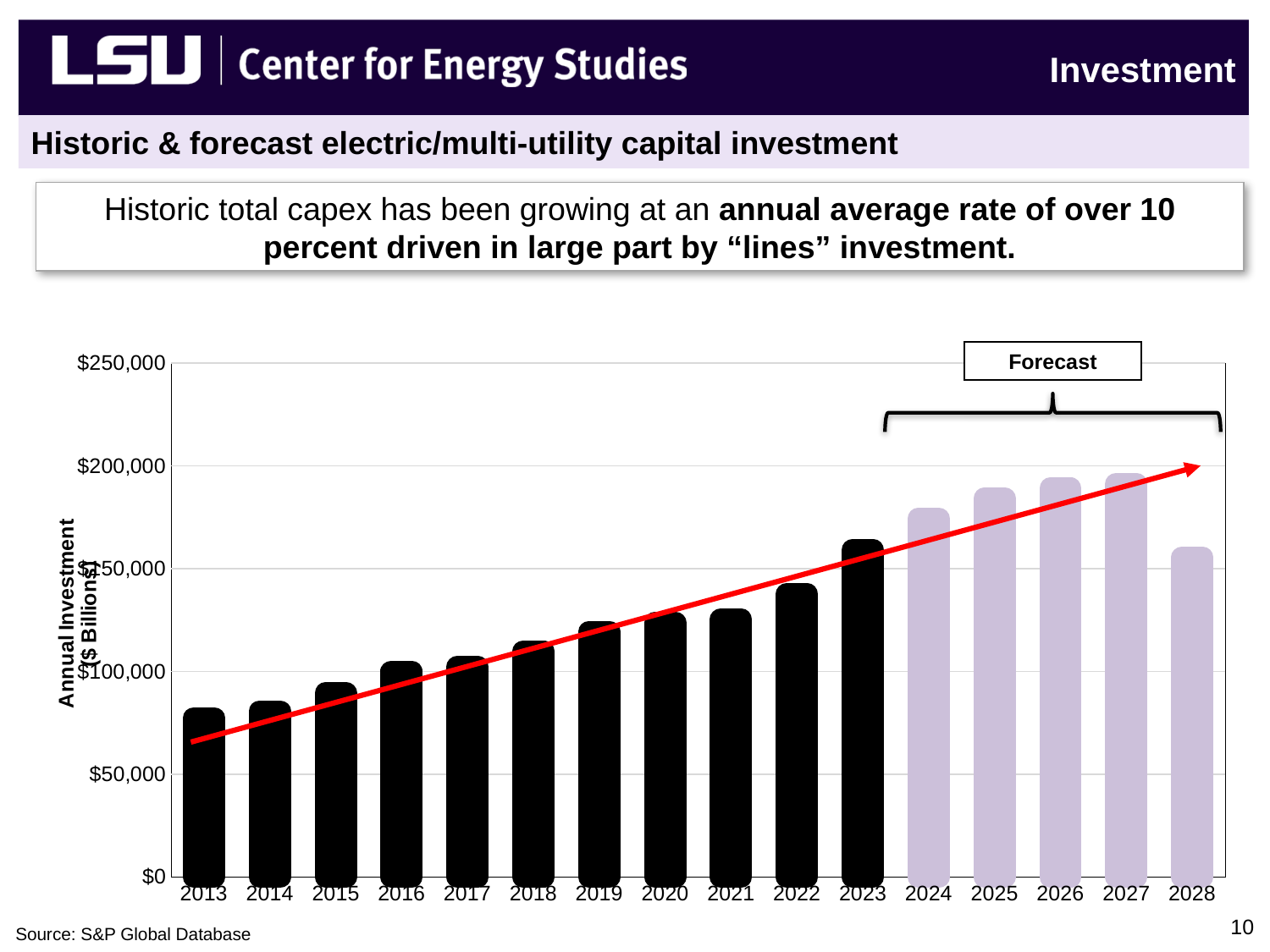
Is the value for 2013 greater or less than $100,000? less Which year has a larger value, 2028 or 2027? 2027 What is the title of the chart on the slide? Historic & forecast electric/multi-utility capital investment Which years are labelled as Forecast on the chart? 2024 to 2028 How many years are shown on the x axis of the chart? 16 Is the value for 2028 greater or less than $150,000? greater Is the value for 2023 greater or less than $150,000? greater What kind of chart is shown on the slide? bar chart Which year has a larger value, 2022 or 2023? 2023 Do the values rise or fall from 2013 to 2023? rise